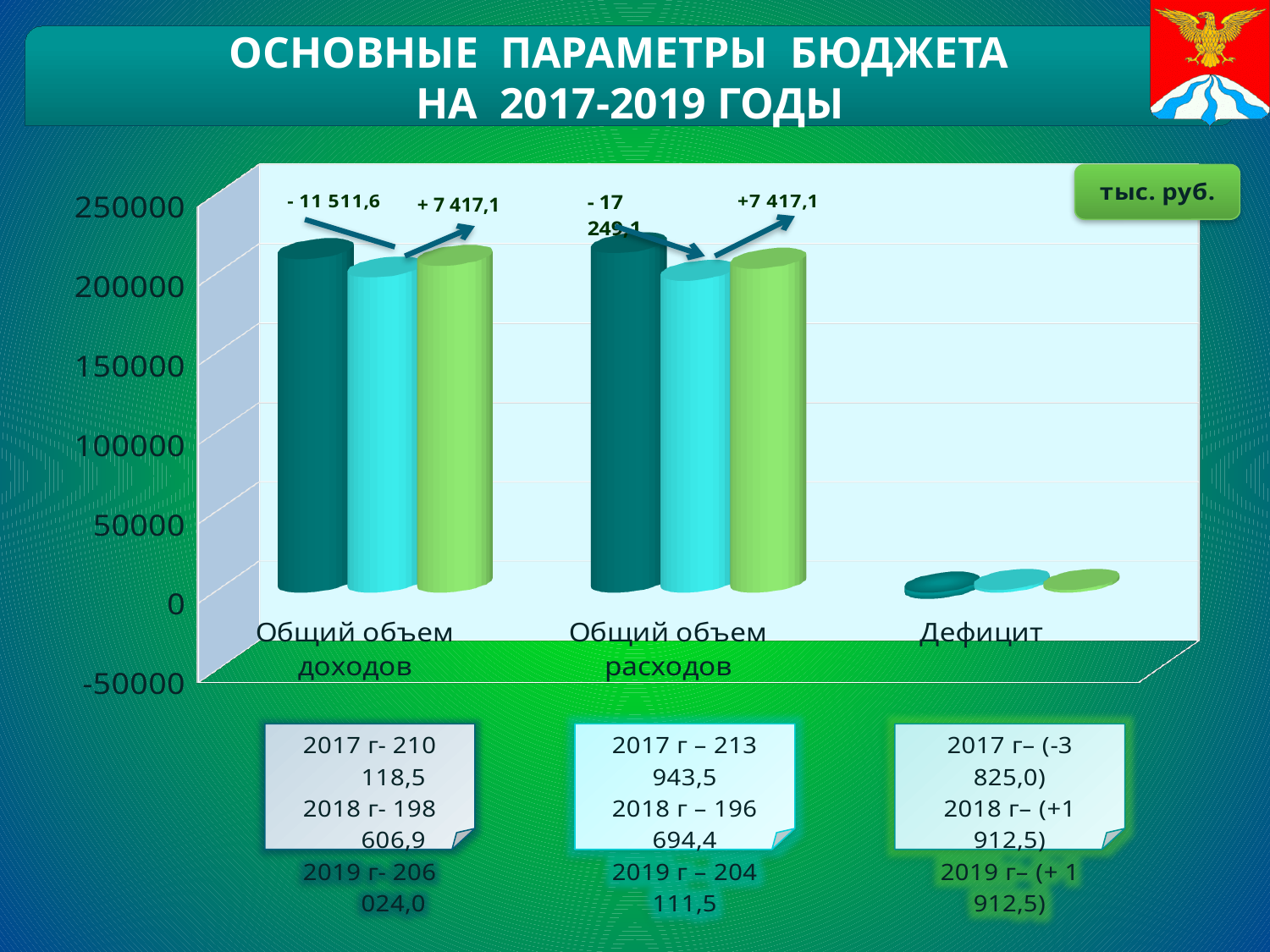
What is the value of Общий объем расходов for 2019 г? 204 111,5 What is the difference between Общий объем расходов and Общий объем доходов in 2017 г? 3 825,0 How many categories are shown along the x axis of the chart? 3 Is the value for Общий объем доходов in 2019 г greater or less than 150000? greater What kind of chart is shown on the slide? bar chart What is the value of Общий объем доходов for 2018 г? 198 606,9 What is the value of Общий объем доходов for 2017 г? 210 118,5 What is the value of Дефицит for 2017 г? (-3 825,0) Which year has the highest value for Общий объем расходов? 2017 г Which is larger in 2017 г: Общий объем доходов or Общий объем расходов? Общий объем расходов What unit is indicated for the values in the chart? тыс. руб. What change in Общий объем доходов is annotated between 2017 г and 2018 г? - 11 511,6